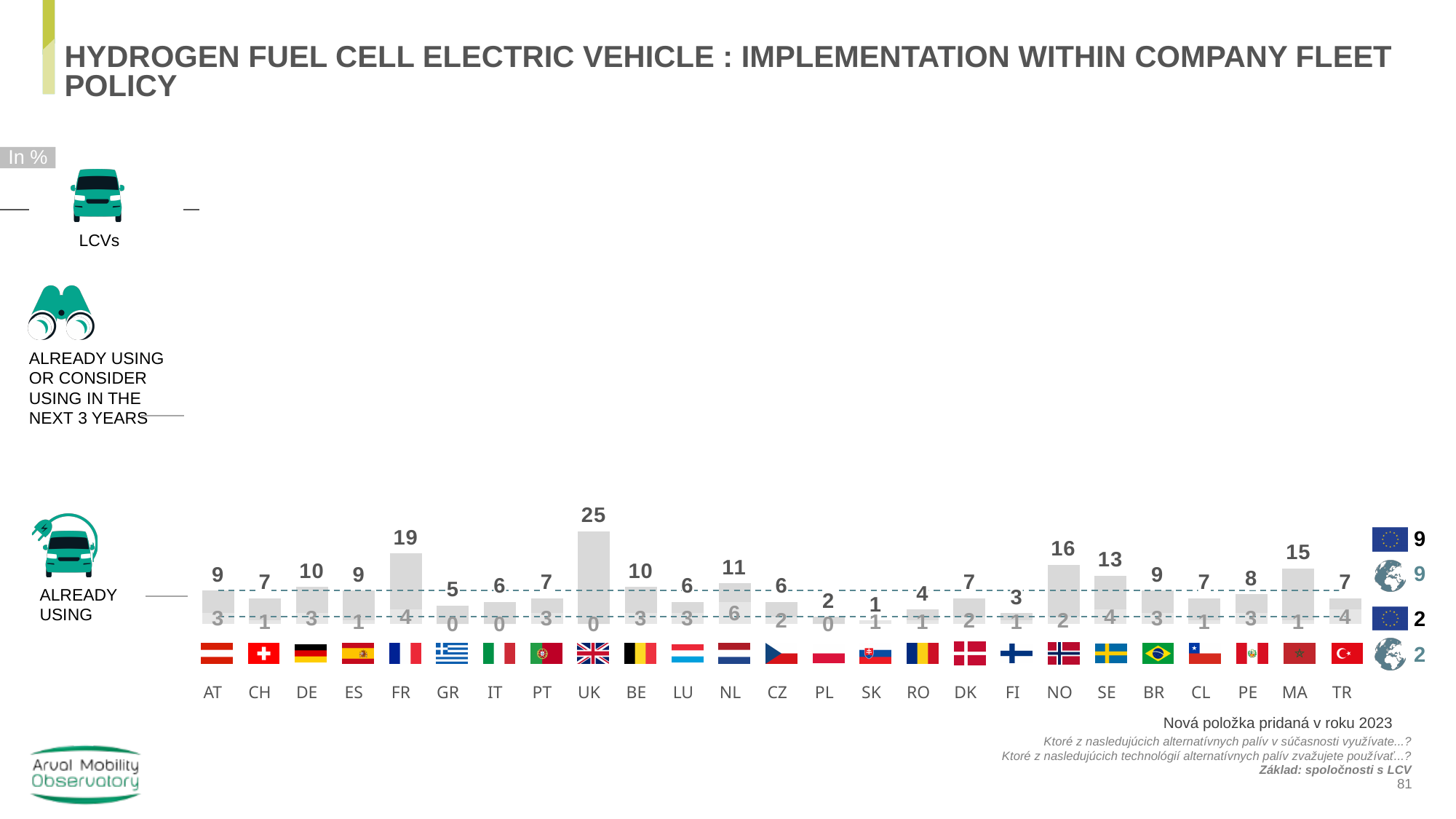
What is the EU average value for 'already using'? 2 How many countries are shown on the chart? 25 What is the 'already using' value for NL? 6 What is the 'already using' value for MA? 1 What is the value for UK for 'already using or consider using in the next 3 years'? 25 What is the difference between the 'already using or consider using' values for UK and FR? 6 What is the value for FR for 'already using or consider using in the next 3 years'? 19 What kind of chart is shown on the slide? Bar chart Which country has the highest value for 'already using or consider using in the next 3 years'? UK Which country has the lowest value for 'already using or consider using in the next 3 years'? SK Which has a higher 'already using or consider using' value, NO or SE? NO What is the difference between the 'already using or consider using' value and the 'already using' value for NL? 5